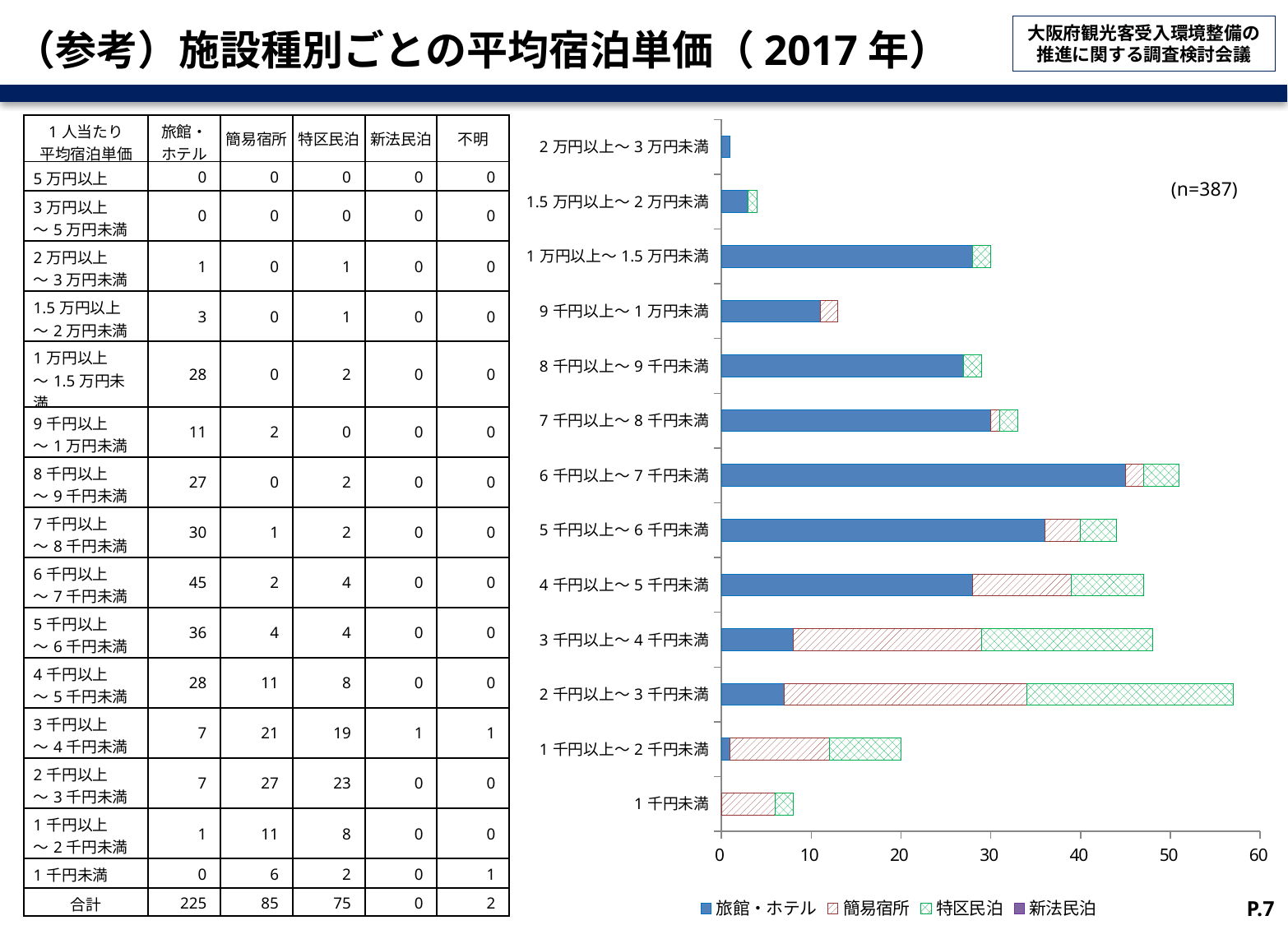
How many price-range categories are plotted on the bar chart? 13 Which has the larger 旅館・ホテル segment: 6千円以上〜7千円未満 or 5千円以上〜6千円未満? 6千円以上〜7千円未満 Which price-range category has the shortest stacked bar in the chart? 2万円以上〜3万円未満 Which colour represents 旅館・ホテル in the bar chart legend? blue What is the total of the stacked bar for 2千円以上〜3千円未満 (旅館・ホテル + 簡易宿所 + 特区民泊)? 57 How many series does the legend of the bar chart list? 4 Is the total length of the bar for 1万円以上〜1.5万円未満 greater or less than 20? greater Is the total length of the bar for 9千円以上〜1万円未満 greater or less than 20? less What sample size (n) is shown next to the bar chart? n=387 Which price-range category has the longest stacked bar in the chart? 2千円以上〜3千円未満 What is the 旅館・ホテル value for the 6千円以上〜7千円未満 category? 45 What kind of chart is shown on the right side of the slide? bar chart